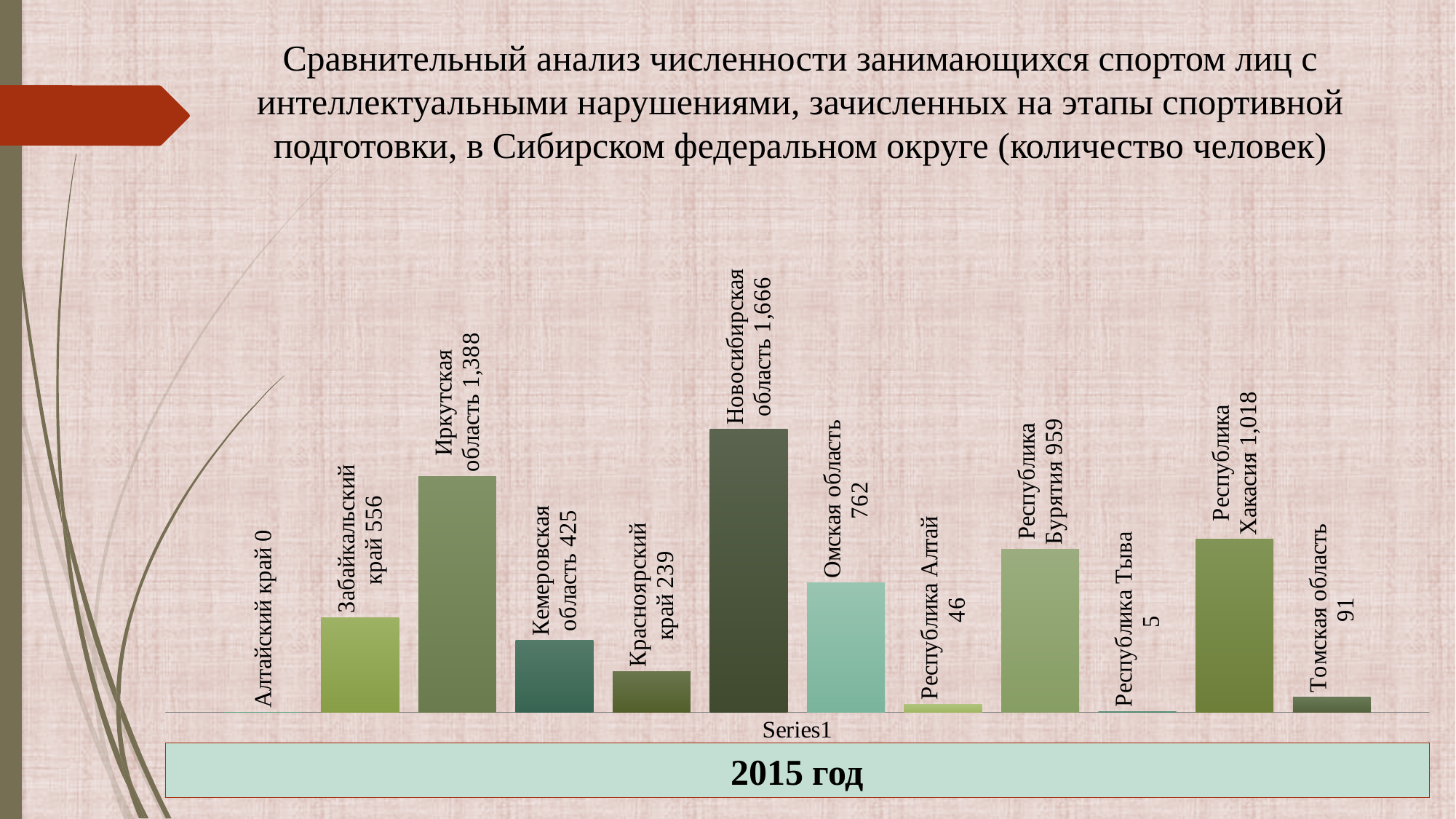
How many regions are shown in the chart? 12 What is the difference between the values for Омская область and Кемеровская область? 337 What is the value for Томская область? 91 Which region has the lowest value? Алтайский край Which region has the highest value? Новосибирская область Which is larger, the value for Забайкальский край or the value for Красноярский край? Забайкальский край What is the value for Республика Бурятия? 959 What kind of chart is shown on the slide? bar chart What is the value for Новосибирская область? 1,666 What year is shown in the box below the chart? 2015 год Which is larger, the value for Республика Алтай or the value for Республика Тыва? Республика Алтай What is the difference between the values for Иркутская область and Республика Хакасия? 370